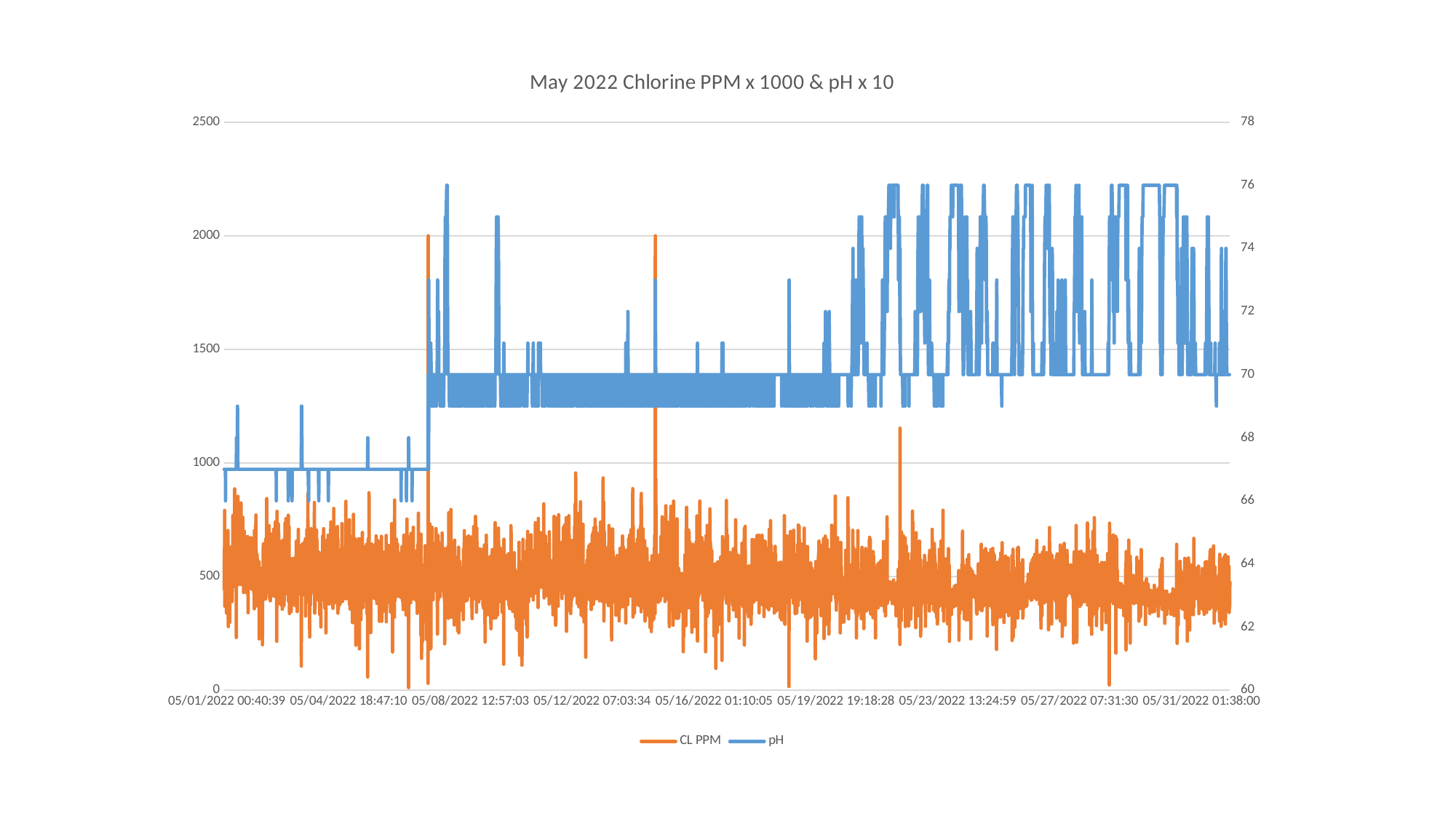
Which series is drawn in orange? CL PPM Is the pH value at the start of the month (05/01/2022) greater or less than 70? less Is the highest pH value reached during the month greater or less than 74? greater How many series does the legend list? 2 Is the pH higher at the start of the month or at the end of the month? end of the month Is the typical pH level around 05/12/2022 greater or less than 72? less What is the title of the chart? May 2022 Chlorine PPM x 1000 & pH x 10 Does the pH series generally rise or fall from the start to the end of May? rise What kind of chart is shown on the slide? line chart